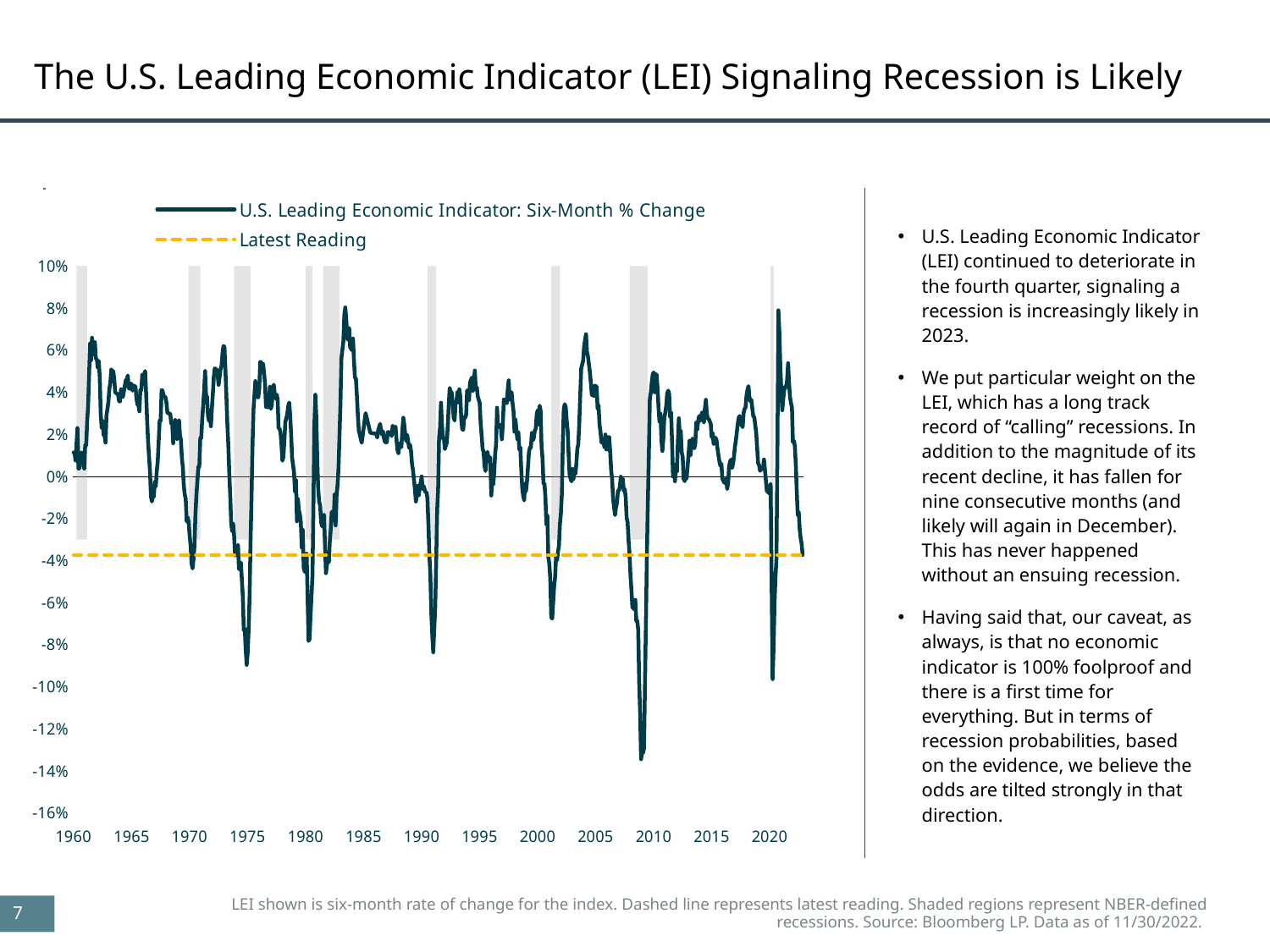
Is the Latest Reading dashed line greater or less than 0%? less Is the trough of the U.S. Leading Economic Indicator line around 1975 greater or less than -6%? less Which trough of the U.S. Leading Economic Indicator line is lower: the one around 2009 or the one around 2020? 2009 What kind of chart is shown on the slide? line chart What is the name of the series plotted as the solid dark line? U.S. Leading Economic Indicator: Six-Month % Change Is the peak of the U.S. Leading Economic Indicator line around 2021 greater or less than 6%? greater From its peak around 2021 to the end of the series, does the U.S. Leading Economic Indicator line rise or fall? fall Around which year does the U.S. Leading Economic Indicator line reach its lowest value? 2009 How many year labels are shown on the x axis? 13 What does the dashed line in the chart represent, according to the legend? Latest Reading How many series does the chart legend list? 2